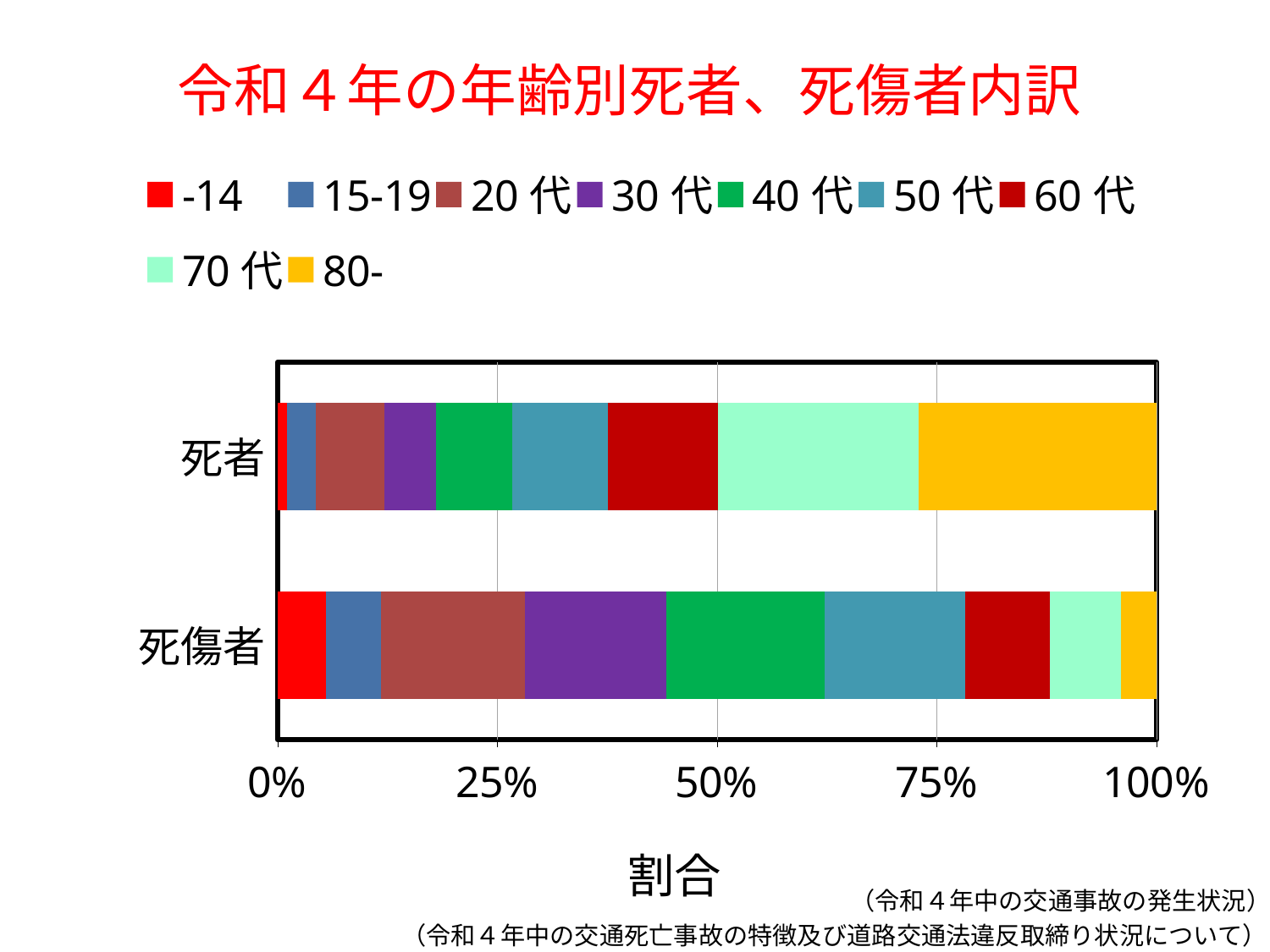
How many bars (categories) are plotted in the chart? 2 How many series does the legend list? 9 Which age group has the smallest segment in the 死者 bar? -14 In the 死傷者 bar, is the cumulative share from -14 through 40 代 greater or less than 50%? greater Which age group has the largest segment in the 死者 bar? 80- Is the 80- segment larger in the 死者 bar or in the 死傷者 bar? 死者 In the 死傷者 bar, is the cumulative share from -14 through 30 代 greater or less than 50%? less What is the title of the chart? 令和４年の年齢別死者、死傷者内訳 What kind of chart is shown on the slide? Stacked bar chart Is the -14 segment larger in the 死者 bar or in the 死傷者 bar? 死傷者 What is the label of the horizontal axis? 割合 Is the 40 代 segment larger in the 死者 bar or in the 死傷者 bar? 死傷者